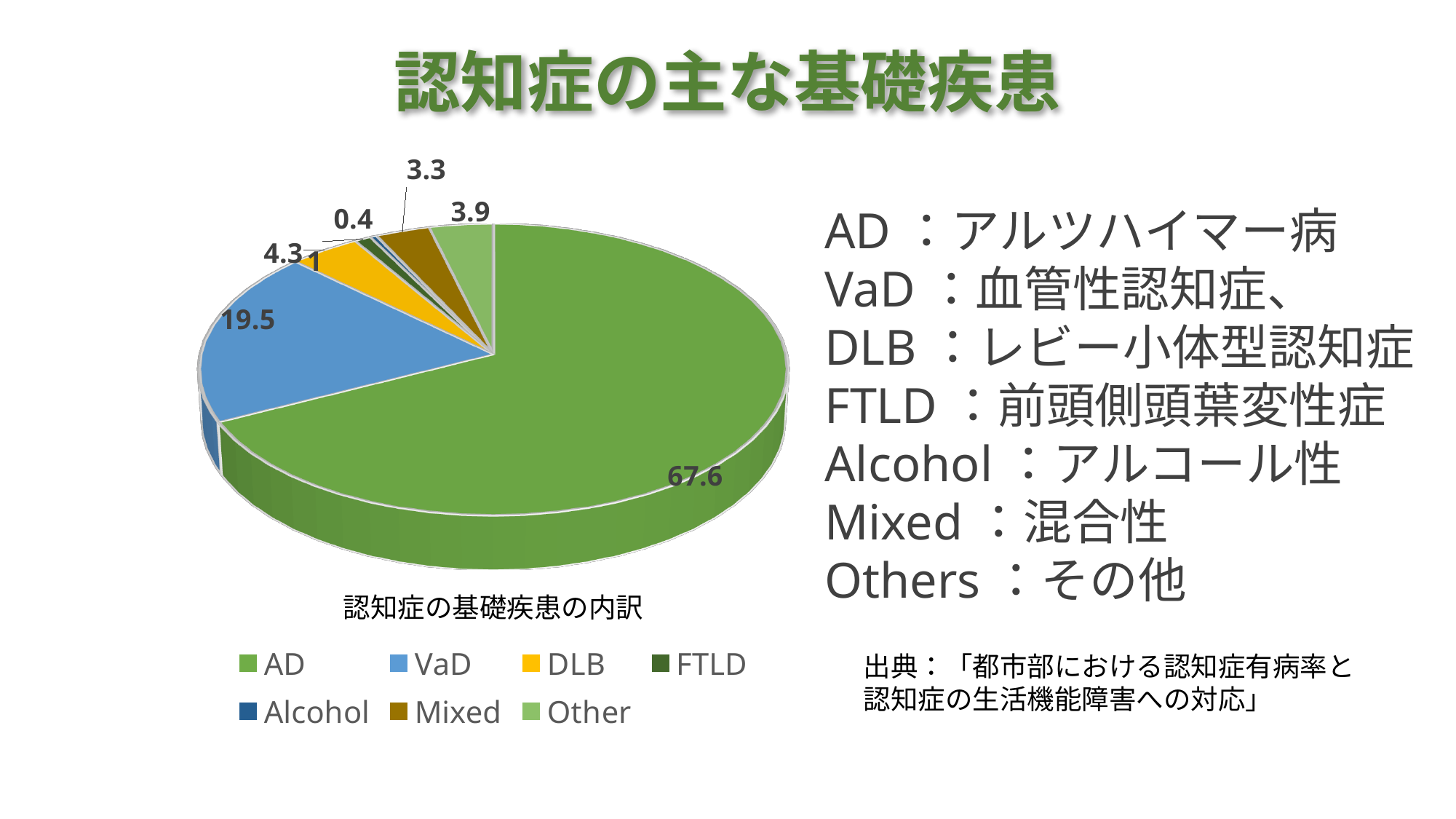
What value is shown for VaD in the pie chart? 19.5 What value is shown for AD in the pie chart? 67.6 How many categories does the pie chart show? 7 What is the title shown below the pie chart? 認知症の基礎疾患の内訳 What value is shown for DLB in the pie chart? 4.3 Which category has the largest slice of the pie chart? AD What kind of chart is shown on the slide? Pie chart What value is shown for Mixed in the pie chart? 3.3 What is the difference between the values for AD and VaD? 48.1 Which is larger, the value for DLB or the value for Other? DLB Which category has the smallest slice of the pie chart? Alcohol What value is shown for Other in the pie chart? 3.9